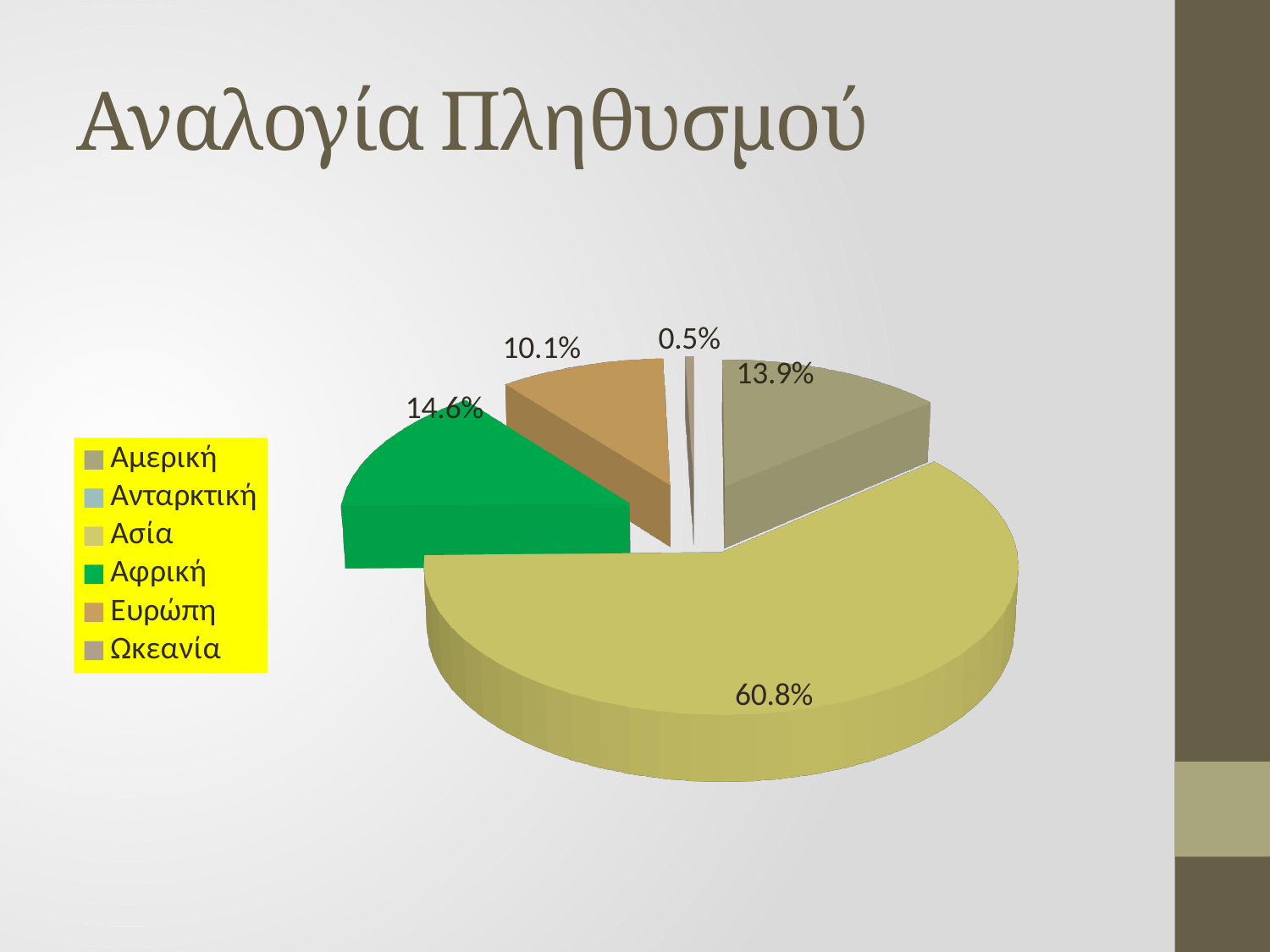
What is the difference in percentage points between Ασία and Αφρική? 46.2 What kind of chart is shown on the slide? Pie chart Which continent has the largest share of the pie? Ασία Which labelled slice of the pie is the smallest? Ωκεανία What percentage is shown for Αφρική? 14.6% What percentage is shown for Ωκεανία? 0.5% Which has the larger share, Αφρική or Αμερική? Αφρική What percentage is shown for Αμερική? 13.9% What is the title of the chart? Αναλογία Πληθυσμού What percentage is shown for Ασία? 60.8% How many entries does the legend list? 6 What percentage is shown for Ευρώπη? 10.1%